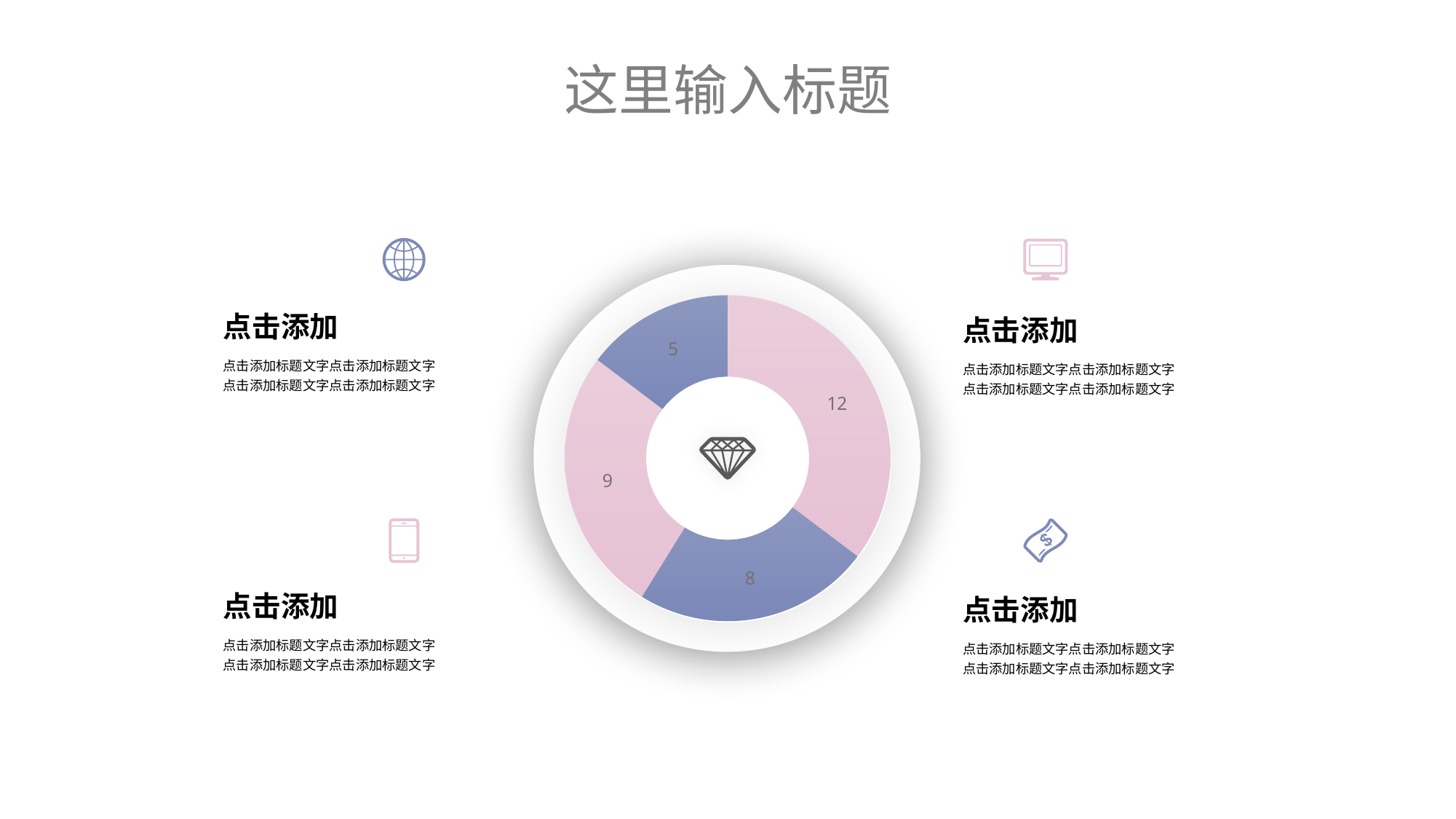
How many slices does the doughnut chart have? 4 What is the smallest value shown on the doughnut chart? 5 Which is larger, the slice labelled 9 or the slice labelled 8? 9 What is the total of all four slice values on the doughnut chart? 34 What colour is the slice labelled 5 on the doughnut chart? blue What value is printed on the top-right pink slice of the doughnut chart? 12 What value is printed on the left pink slice of the doughnut chart? 9 What is the sum of the two pink slices (12 and 9) on the doughnut chart? 21 What kind of chart is shown in the centre of the slide? doughnut (pie) chart What is the difference between the largest slice value (12) and the smallest slice value (5)? 7 What value is printed on the bottom blue slice of the doughnut chart? 8 What is the largest value shown on the doughnut chart? 12